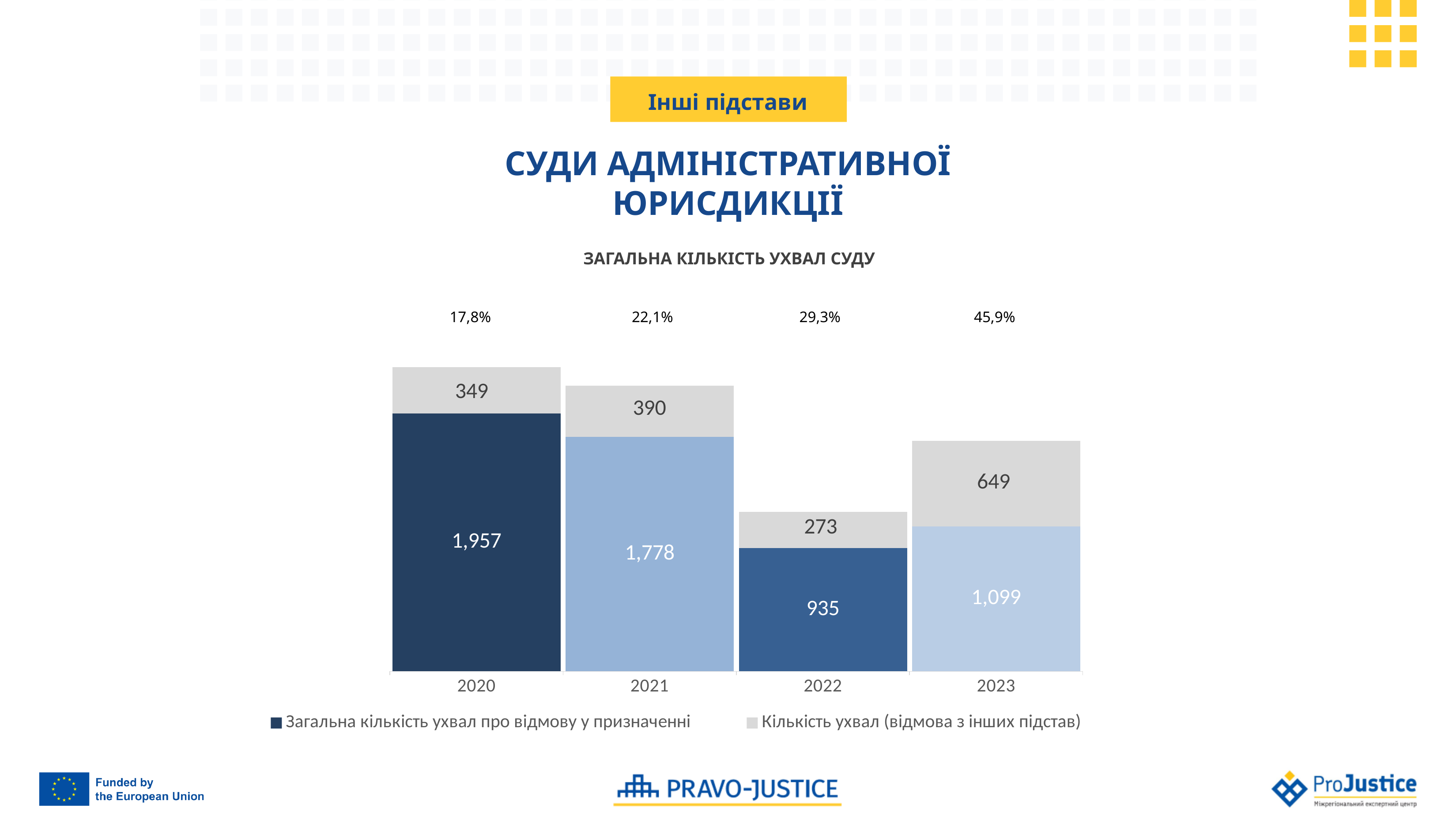
What is the difference between the "Загальна кількість ухвал про відмову у призначенні" values for 2020 and 2021? 179 How many years are shown on the x axis? 4 Which year has the highest value for "Кількість ухвал (відмова з інших підстав)"? 2023 What percentage is shown above the bar for 2021? 22,1% What is the value of "Кількість ухвал (відмова з інших підстав)" for 2023? 649 How many series does the legend list? 2 What is the value of "Кількість ухвал (відмова з інших підстав)" for 2022? 273 Which year has the lowest value for "Загальна кількість ухвал про відмову у призначенні"? 2022 What kind of chart is shown on the slide? Stacked bar chart What is the total of the stacked bar for 2022? 1,208 What is the value of "Загальна кількість ухвал про відмову у призначенні" for 2020? 1,957 Which is larger: the "Кількість ухвал (відмова з інших підстав)" value for 2021 or for 2020? 2021